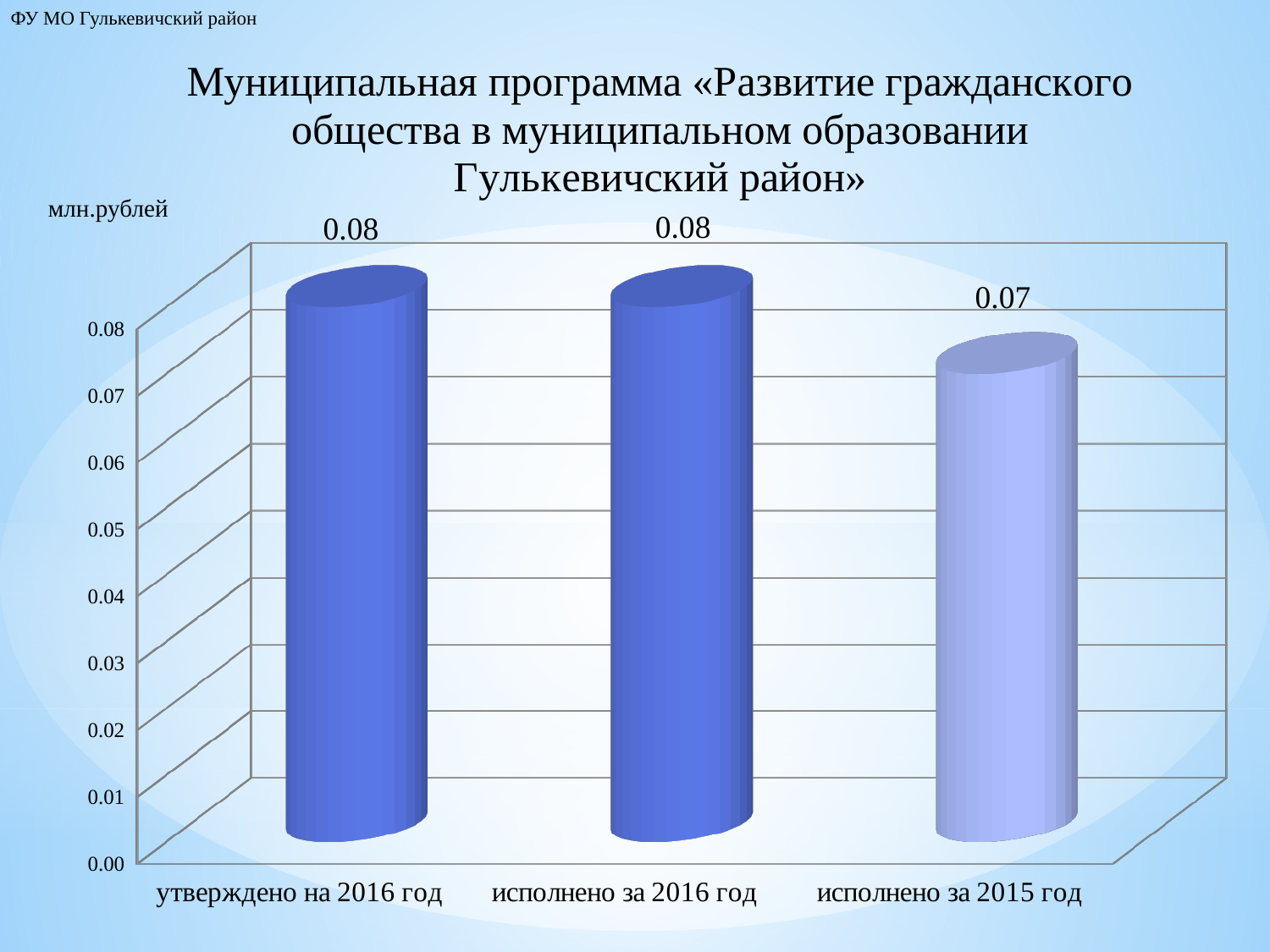
What is the value for «утверждено на 2016 год»? 0.08 Which category has the lowest value? исполнено за 2015 год What kind of chart is shown on the slide? bar chart What unit of measurement is indicated above the chart? млн.рублей Which is larger: the value for «исполнено за 2016 год» or the value for «исполнено за 2015 год»? исполнено за 2016 год What is the difference between the values for «утверждено на 2016 год» and «исполнено за 2015 год»? 0.01 Is the value for «исполнено за 2015 год» greater or less than 0.05? greater What is the value for «исполнено за 2016 год»? 0.08 What is the highest tick value shown on the vertical axis? 0.08 Do the values rise or fall from the first category to the last category along the x axis? fall What is the value for «исполнено за 2015 год»? 0.07 How many categories are shown on the chart? 3